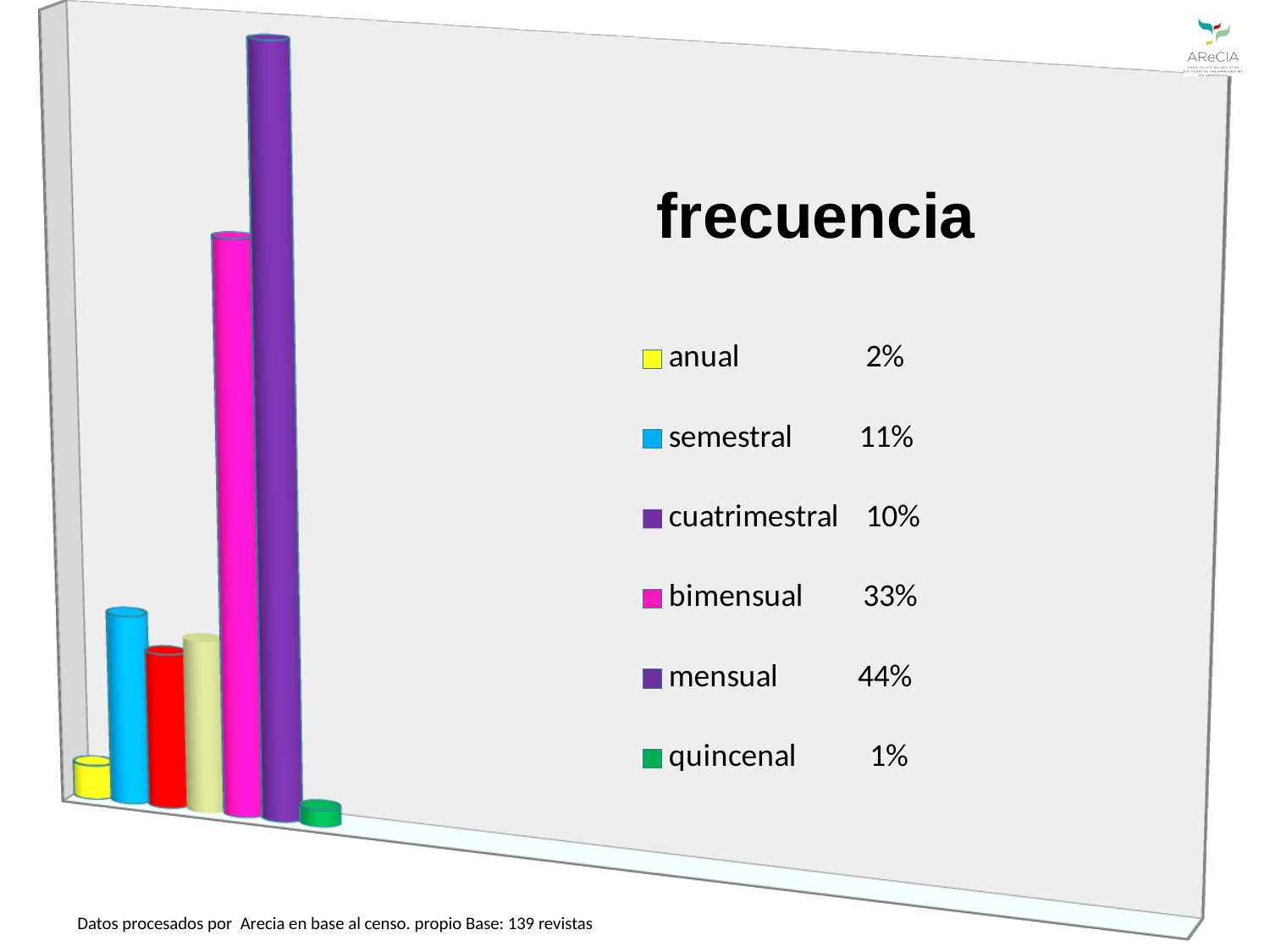
What percentage is shown for bimensual? 33% How many categories does the legend list? 6 What is the title of the chart? frecuencia Which is larger, the percentage for semestral or for cuatrimestral? semestral Which category has the lowest percentage? quincenal What percentage is shown for quincenal? 1% What kind of chart is shown on the slide? bar chart What is the difference between the percentages for mensual and bimensual? 11% What is the difference between the percentages for anual and quincenal? 1% What percentage is shown for semestral? 11% Which category has the highest percentage? mensual What percentage is shown for mensual? 44%